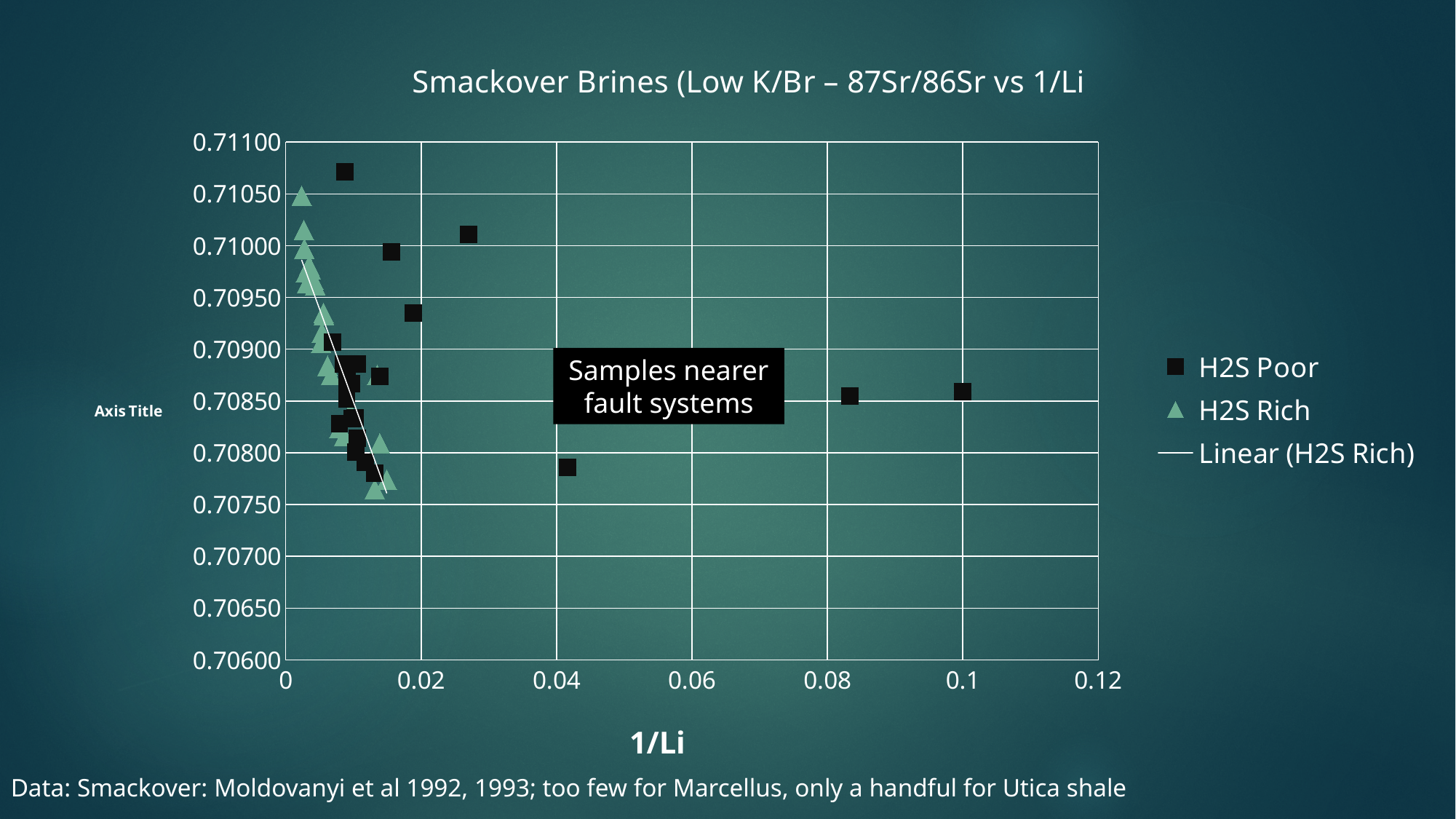
Is the 87Sr/86Sr value of the H2S Poor point near 1/Li = 0.1 greater or less than 0.70900? less What is the title of the chart? Smackover Brines (Low K/Br – 87Sr/86Sr vs 1/Li Does the Linear (H2S Rich) trendline rise or fall as 1/Li increases? Fall Are all of the H2S Rich points plotted at 1/Li values less than or greater than 0.02? less Is the 87Sr/86Sr value of the H2S Poor point near 1/Li = 0.08 greater or less than 0.70800? greater How many entries does the chart legend list? 3 What kind of chart is shown on the slide? Scatter chart Which series contains the point with the largest 1/Li value? H2S Poor Which series is plotted with green triangle markers? H2S Rich Which series contains the point with the highest 87Sr/86Sr value on the chart? H2S Poor